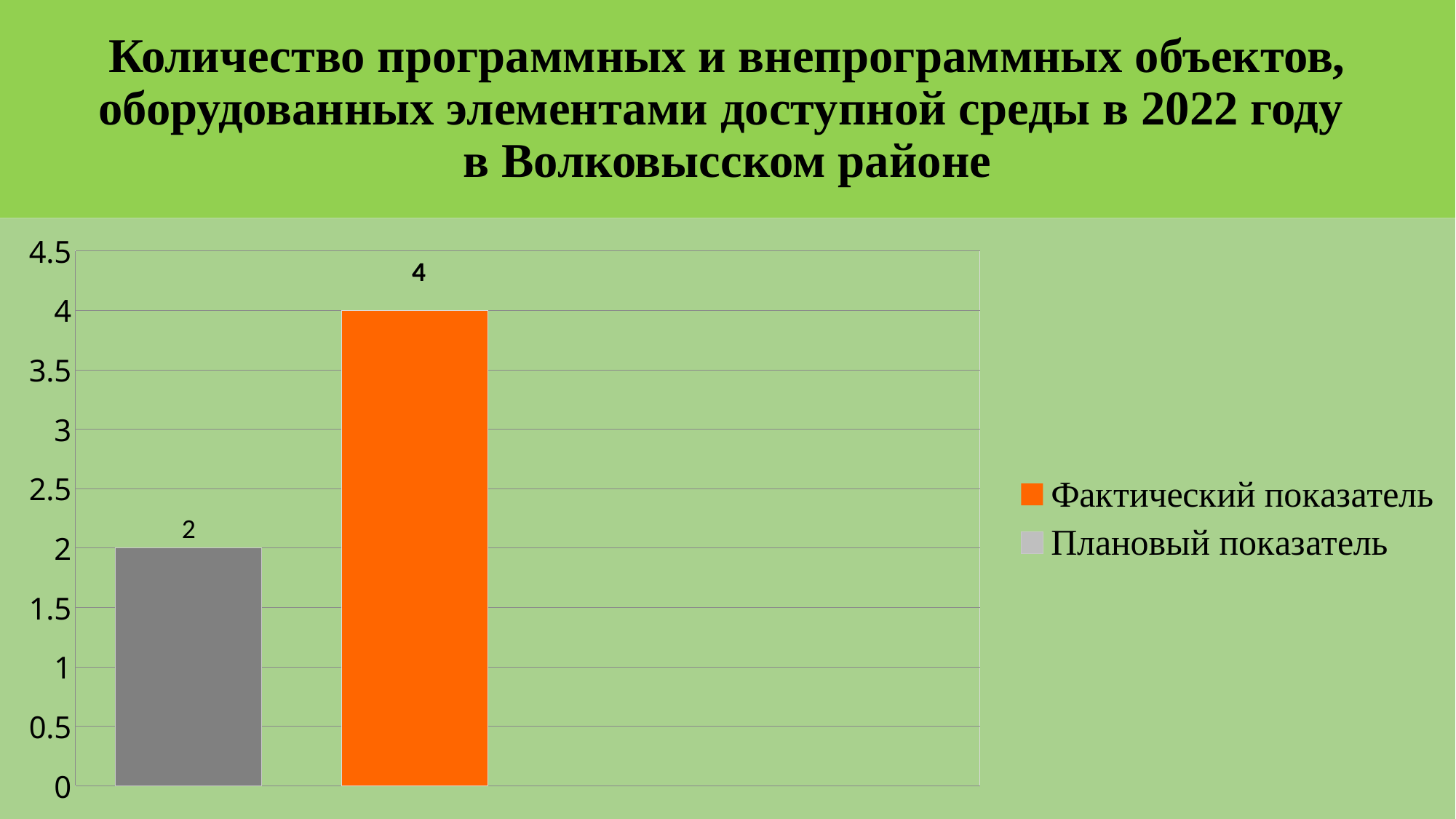
Is the value for Плановый показатель greater or less than 2.5? less Which series has the higher value, Фактический показатель or Плановый показатель? Фактический показатель What kind of chart is shown on the slide? bar chart Which bar is the highest? Фактический показатель What is the difference between the Фактический показатель and Плановый показатель values? 2 How many bars are plotted on the chart? 2 Which bar is the lowest? Плановый показатель How many series does the legend list? 2 What is the value of the Плановый показатель bar? 2 What colour is the Фактический показатель bar? orange Is the value for Фактический показатель greater or less than 3? greater What is the value of the Фактический показатель bar? 4